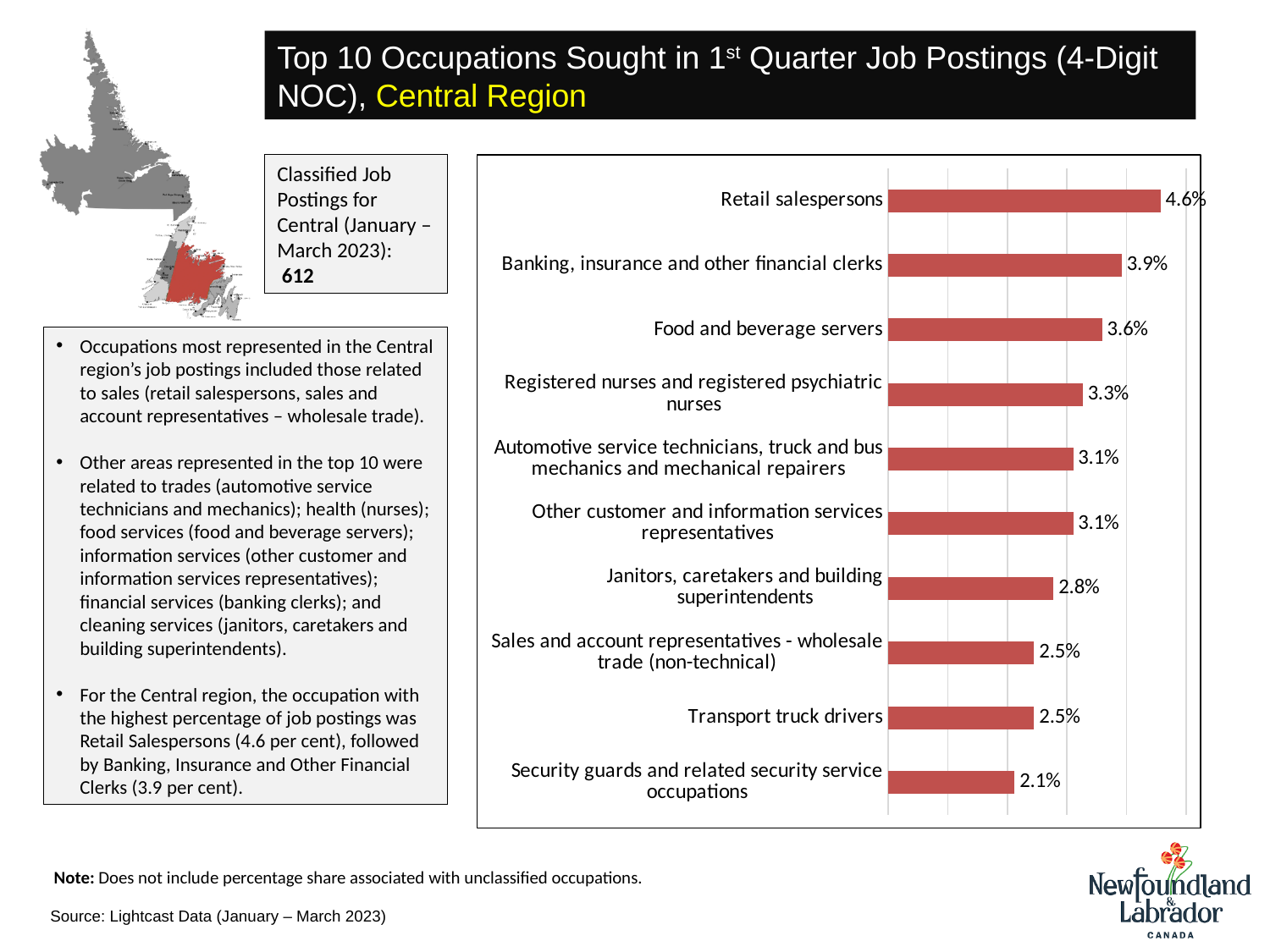
Which occupation has the highest percentage of job postings? Retail salespersons What is the value for Janitors, caretakers and building superintendents? 2.8% What is the value for Security guards and related security service occupations? 2.1% How many occupations are shown in the chart? 10 What kind of chart is shown on the slide? Bar chart Which is larger: the value for Food and beverage servers or the value for Transport truck drivers? Food and beverage servers What is the value for Banking, insurance and other financial clerks? 3.9% What is the value for Registered nurses and registered psychiatric nurses? 3.3% What is the difference between the values for Retail salespersons and Banking, insurance and other financial clerks? 0.7% What is the difference between the values for Food and beverage servers and Security guards and related security service occupations? 1.5% What percentage of job postings is shown for Retail salespersons? 4.6% Which occupation has the lowest percentage of job postings? Security guards and related security service occupations